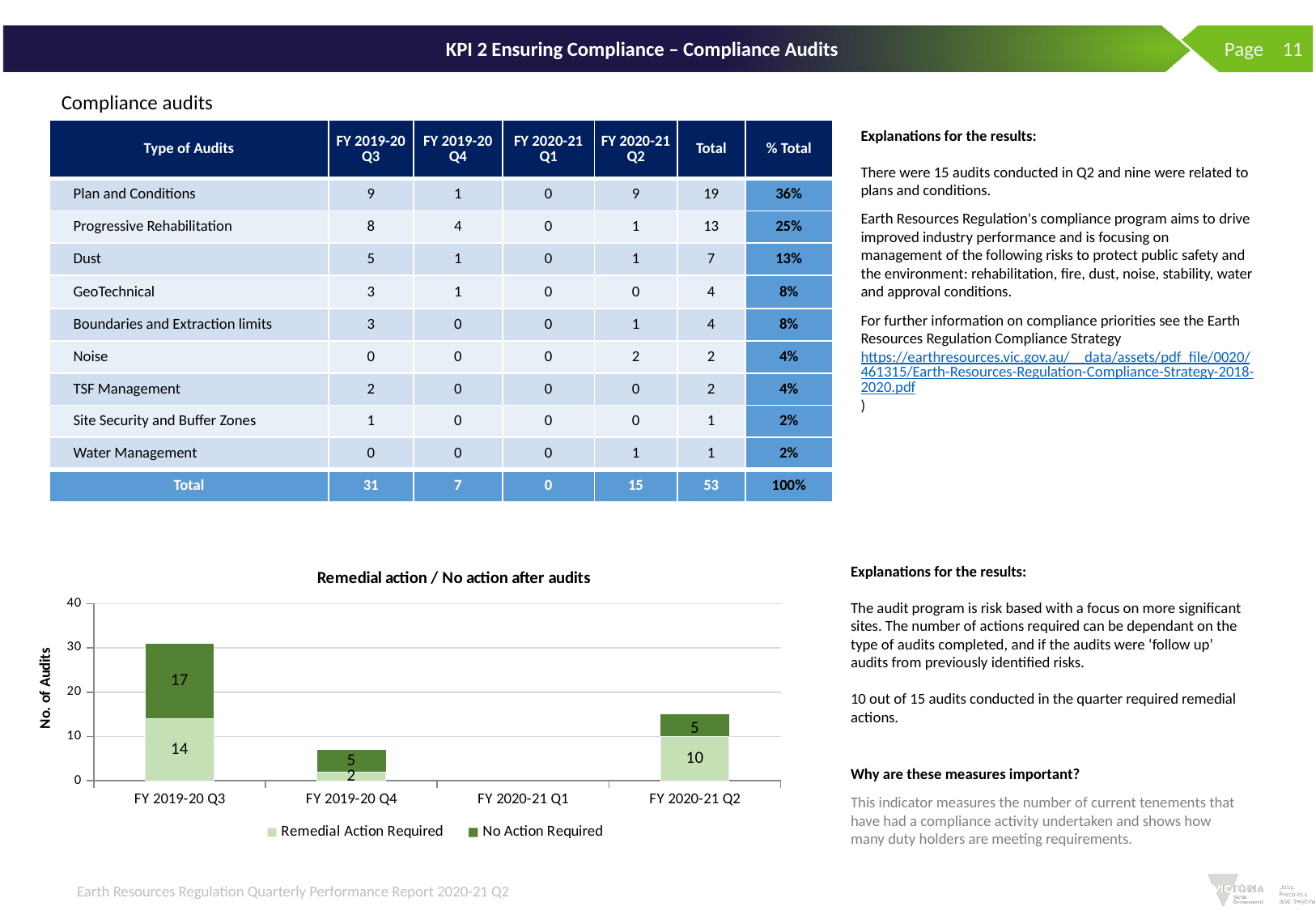
In the 'Remedial action / No action after audits' chart, what is the difference between Remedial Action Required in FY 2020-21 Q2 and in FY 2019-20 Q4? 8 In the 'Remedial action / No action after audits' chart, what is the value for Remedial Action Required in FY 2019-20 Q3? 14 In the 'Remedial action / No action after audits' chart, which quarter has the highest total number of audits? FY 2019-20 Q3 In the 'Remedial action / No action after audits' chart, what is the total height of the stacked bar for FY 2019-20 Q3? 31 In the 'Remedial action / No action after audits' chart, what is the value for No Action Required in FY 2019-20 Q4? 5 In the 'Remedial action / No action after audits' chart, what is the value for No Action Required in FY 2019-20 Q3? 17 In the 'Remedial action / No action after audits' chart, what is the value for Remedial Action Required in FY 2020-21 Q2? 10 In the 'Remedial action / No action after audits' chart, what is the total height of the stacked bar for FY 2020-21 Q2? 15 In the 'Remedial action / No action after audits' chart, which is larger in FY 2020-21 Q2: Remedial Action Required or No Action Required? Remedial Action Required How many series does the legend of the 'Remedial action / No action after audits' chart list? 2 How many quarters are shown on the x axis of the 'Remedial action / No action after audits' chart? 4 What type of chart is 'Remedial action / No action after audits'? stacked bar chart